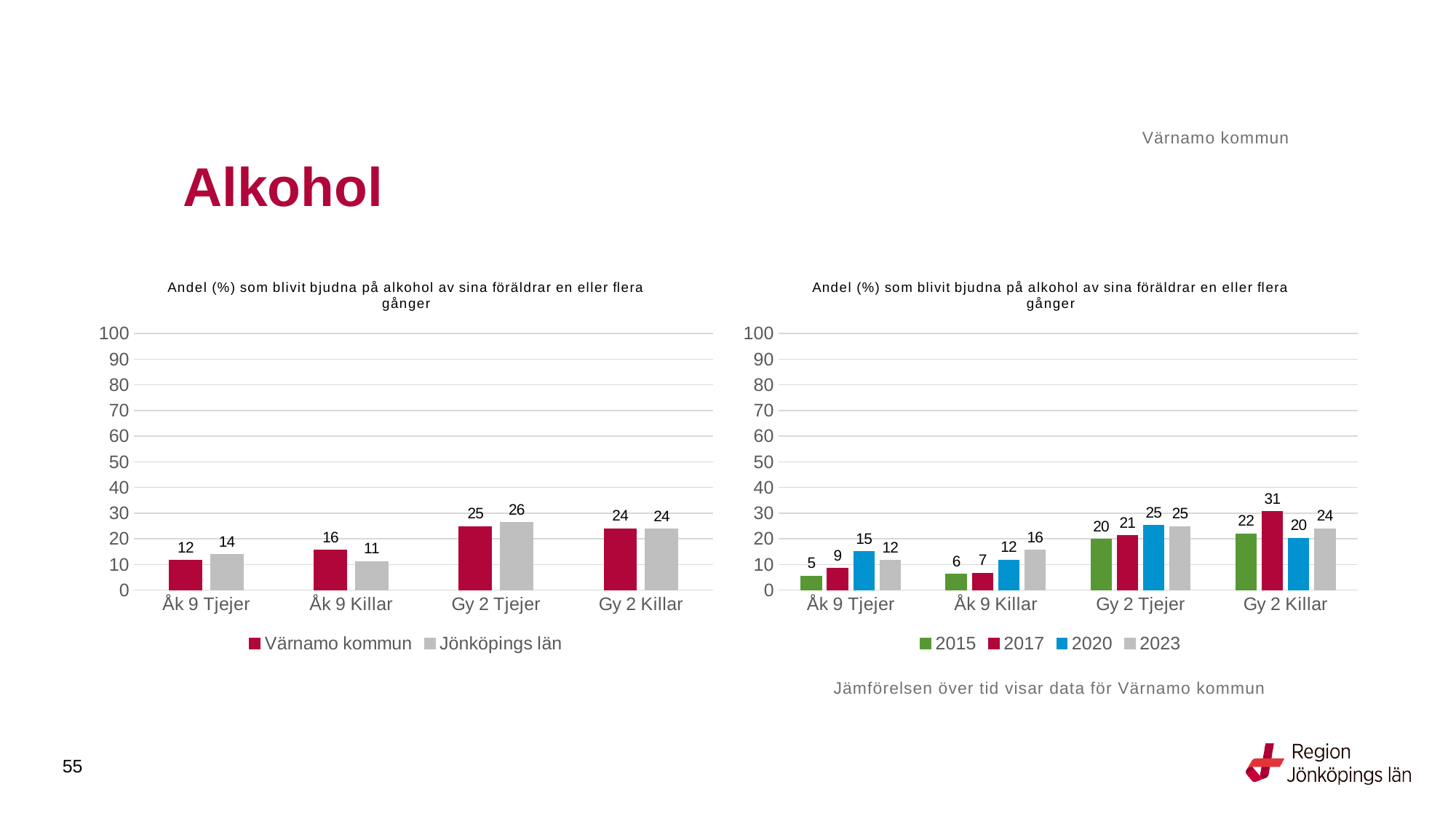
In the right chart, which category has the lowest value for 2015? Åk 9 Tjejer In the left chart, which category has the highest value for Värnamo kommun? Gy 2 Tjejer In the right chart, how many series does the legend list? 4 In the right chart, how many categories are shown on the x axis? 4 In the left chart, how many series does the legend list? 2 What kind of chart is the left chart? bar chart In the left chart, what is the value for Värnamo kommun for Åk 9 Tjejer? 12 In the right chart, what is the value for 2017 for Gy 2 Killar? 31 In the right chart, what is the value for 2020 for Gy 2 Tjejer? 25 In the left chart, what is the value for Jönköpings län for Gy 2 Tjejer? 26 In the left chart, what is the difference between Värnamo kommun and Jönköpings län for Åk 9 Killar? 5 In the right chart, is the value for 2023 for Åk 9 Killar larger or smaller than the value for 2015 for Åk 9 Killar? larger